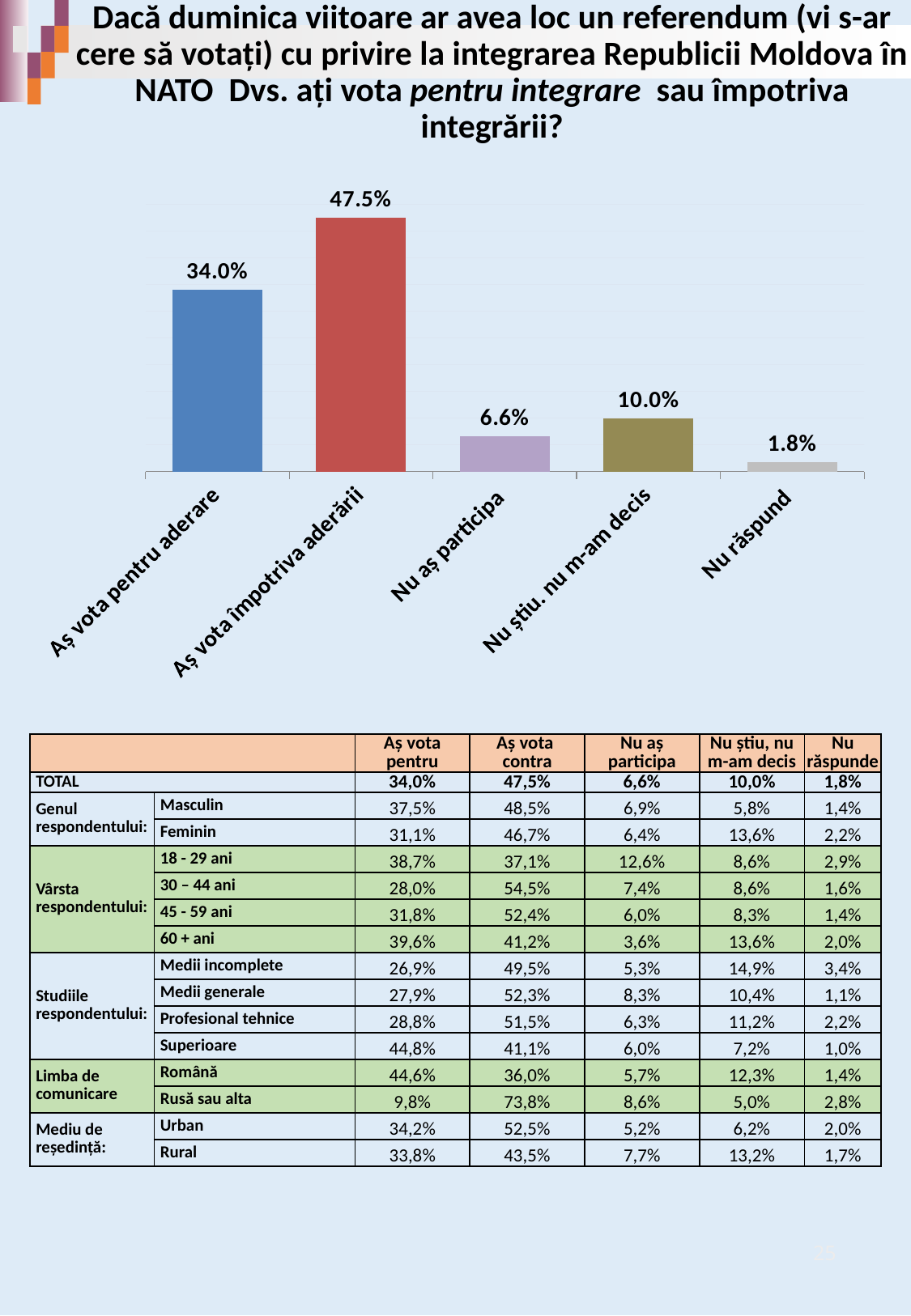
What is the difference between "Aș vota împotriva aderării" and "Aș vota pentru aderare"? 13.5% Which is larger, "Nu aș participa" or "Nu știu. nu m-am decis"? Nu știu. nu m-am decis What is the value for "Nu aș participa"? 6.6% Which category has the highest value? Aș vota împotriva aderării What is the value for "Aș vota pentru aderare"? 34.0% How many categories are shown in the chart? 5 What is the difference between "Nu știu. nu m-am decis" and "Nu aș participa"? 3.4% What kind of chart is shown on the slide? Bar chart What is the value for "Aș vota împotriva aderării"? 47.5% What is the value for "Nu știu. nu m-am decis"? 10.0% What is the value for "Nu răspund"? 1.8% Which category has the lowest value? Nu răspund